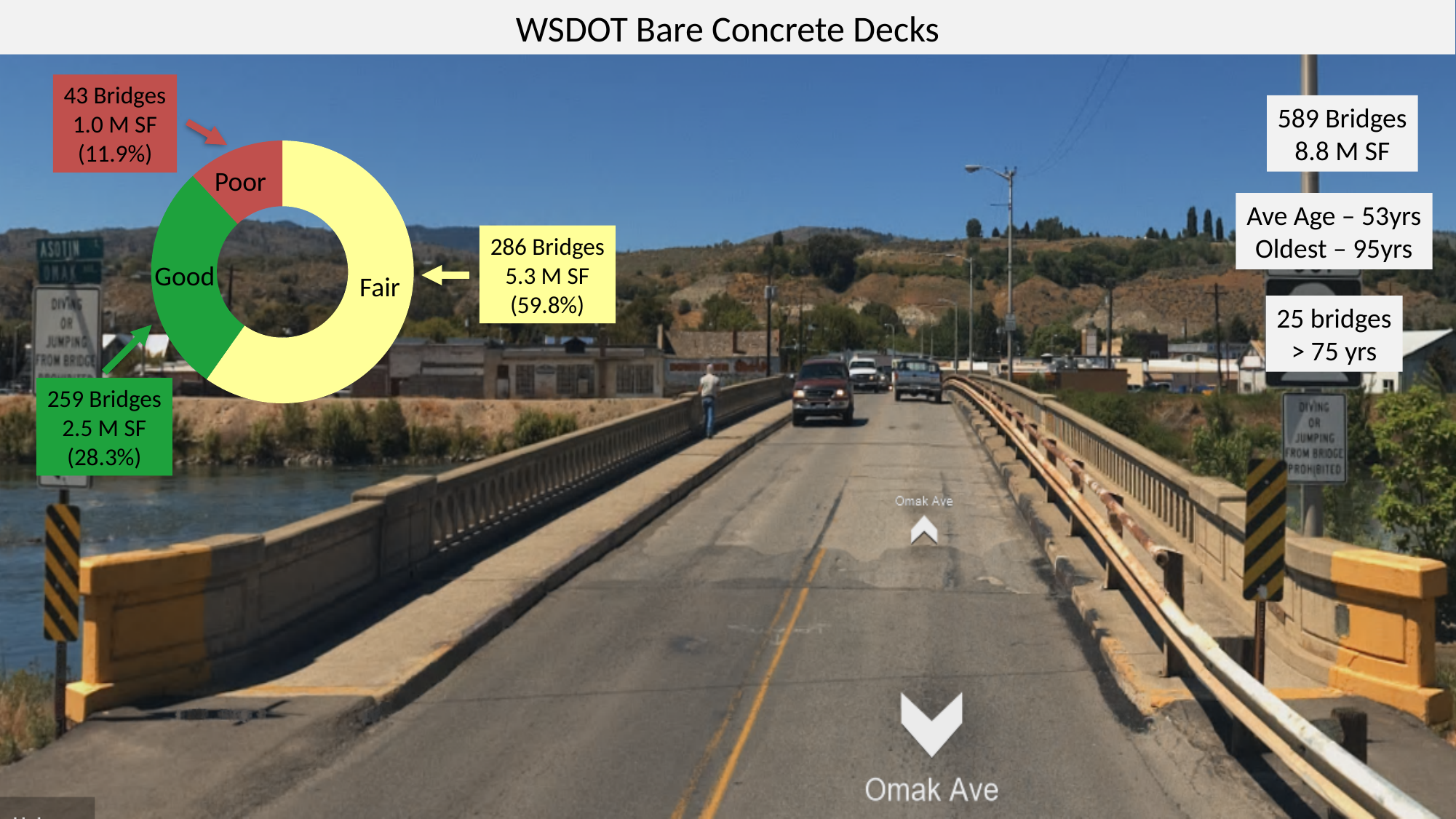
What is the deck area (M SF) for the Good category? 2.5 M SF What percentage share does the Poor category have? 11.9% Which category has the largest share of the donut chart? Fair How many categories does the donut chart have? 3 How many more bridges are in the Good category than in the Poor category? 216 How many bridges are in the Poor category? 43 Bridges What colour represents the Good category in the donut chart? Green How many bridges are in the Fair category? 286 Bridges Which category has the smallest share of the donut chart? Poor What kind of chart is shown on the slide? Donut (pie) chart What percentage share does the Fair category have? 59.8% Which category has more bridges, Good or Fair? Fair